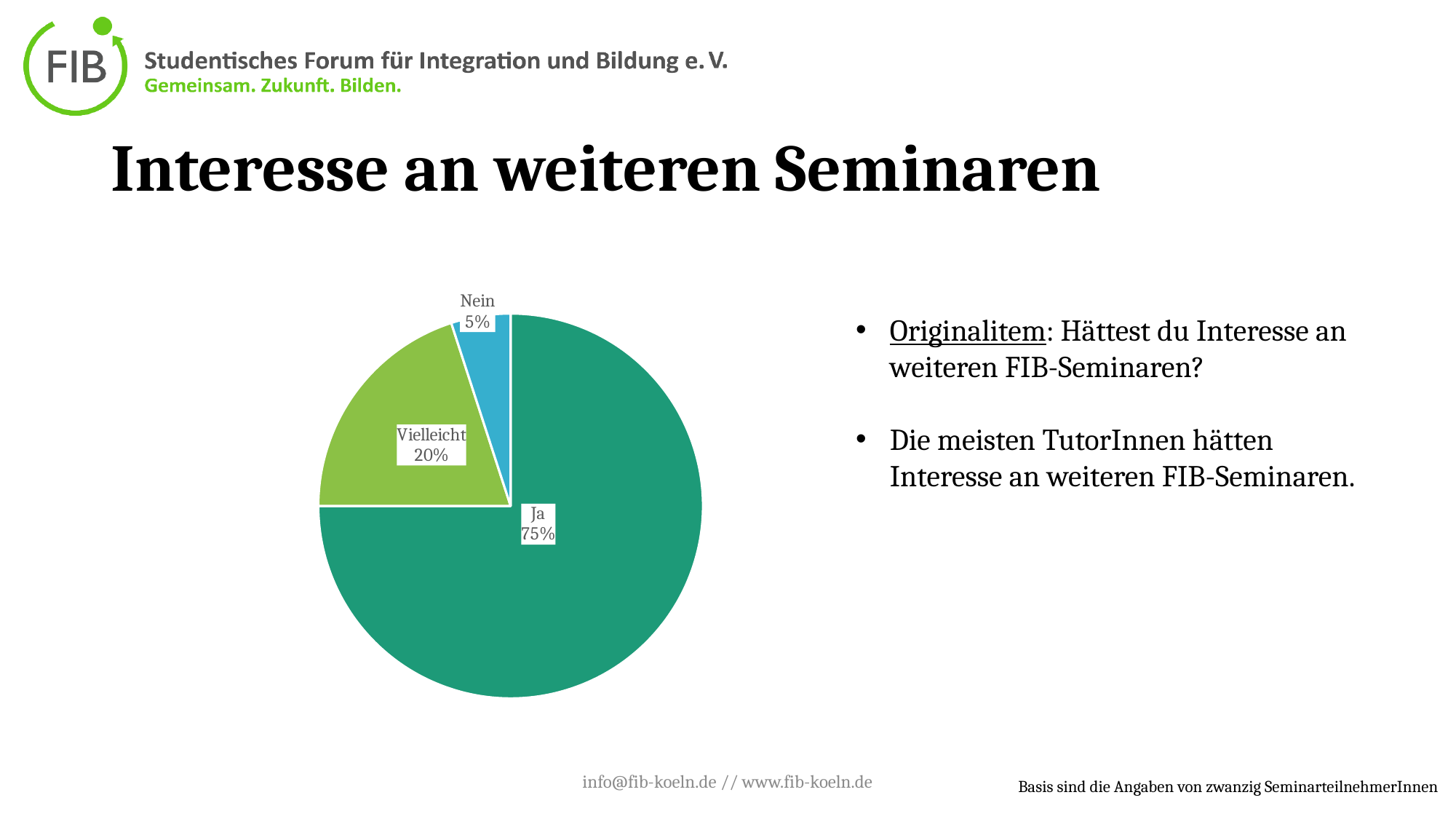
What kind of chart is shown on the slide? pie chart What is the difference in percentage points between the "Vielleicht" and "Nein" slices? 15 What share of the pie does the "Nein" slice represent? 5% What is the difference in percentage points between the "Ja" and "Vielleicht" slices? 55 What is the title of the slide containing the pie chart? Interesse an weiteren Seminaren Which slice is larger, "Vielleicht" or "Nein"? Vielleicht Which category has the smallest slice of the pie? Nein What share of the pie does the "Vielleicht" slice represent? 20% How many slices does the pie chart have? 3 Which category has the largest slice of the pie? Ja What colour is the "Nein" slice of the pie? blue What share of the pie does the "Ja" slice represent? 75%